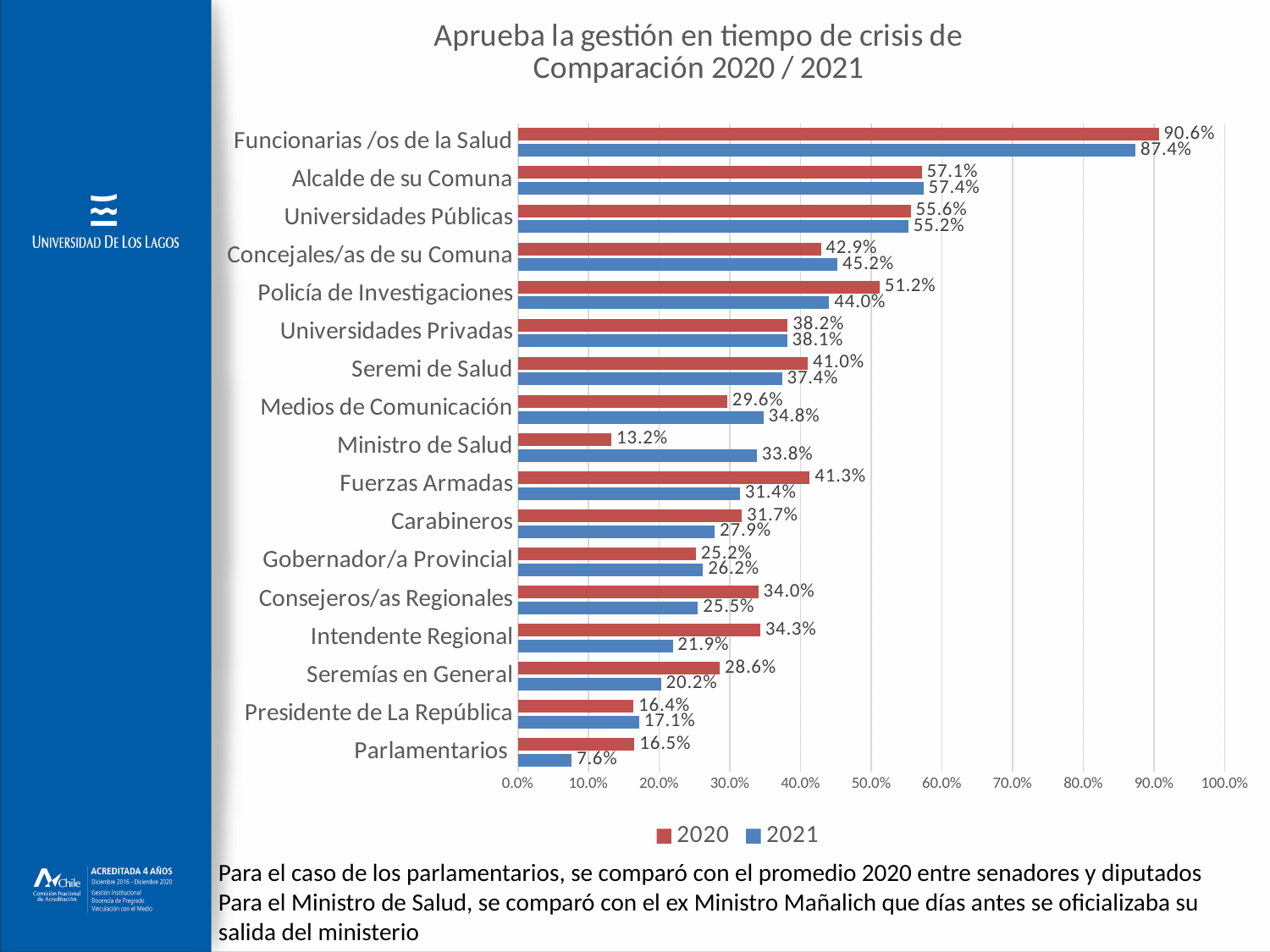
What is the 2020 value for Ministro de Salud? 13.2% What is the difference between the 2020 and 2021 values for Intendente Regional? 12.4% What is the 2021 value for Parlamentarios? 7.6% Which category has the lowest 2020 value? Ministro de Salud How many series does the legend list? 2 For Fuerzas Armadas, which year has the larger value, 2020 or 2021? 2020 Which category has the lowest 2021 value? Parlamentarios What is the difference between the 2021 and 2020 values for Ministro de Salud? 20.6% How many categories are shown on the chart? 17 What type of chart is shown on the slide? Bar chart What is the 2021 value for Policía de Investigaciones? 44.0% Which category has the highest 2021 value? Funcionarias /os de la Salud